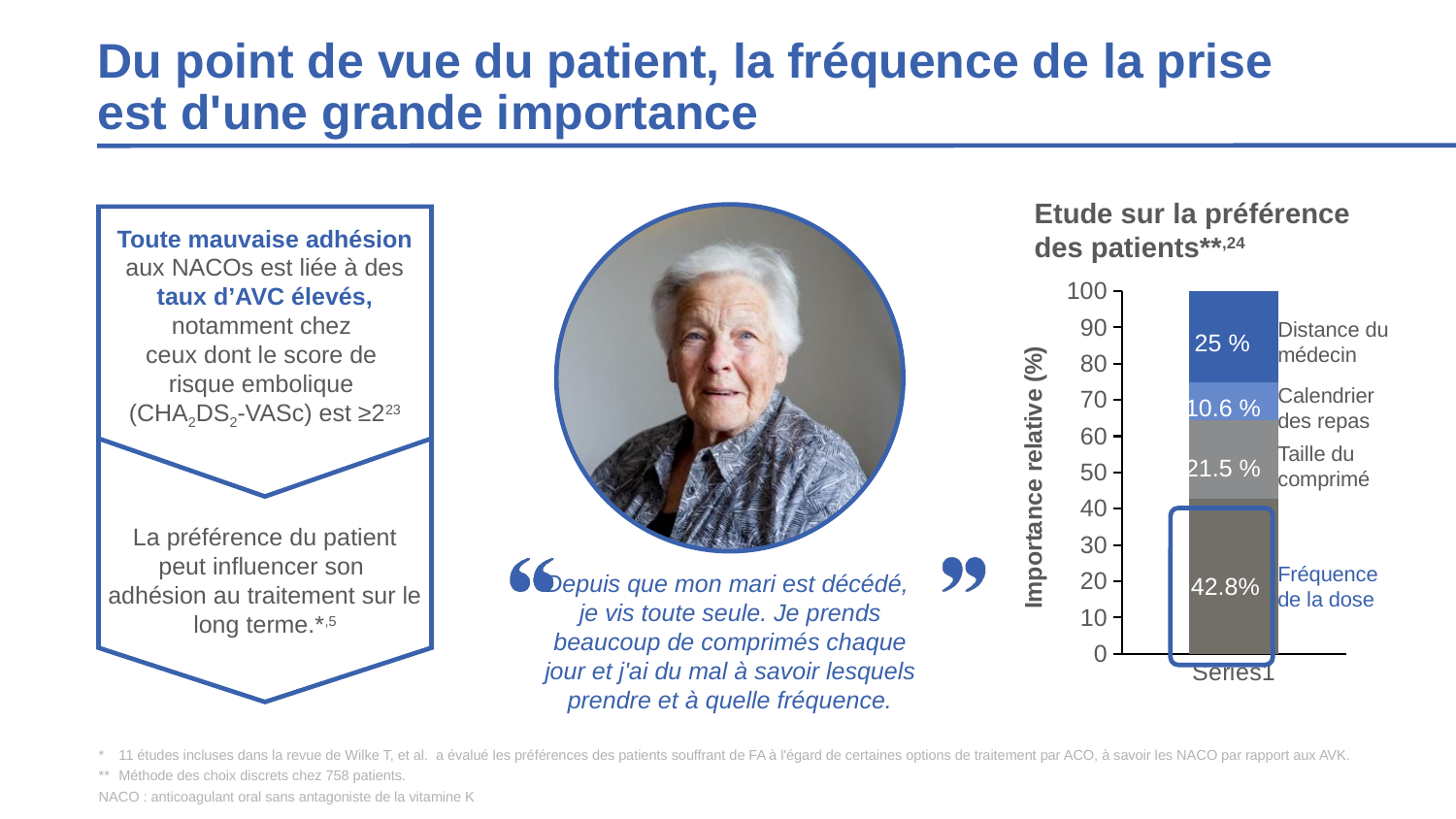
Which has a larger value, "Distance du médecin" or "Taille du comprimé"? Distance du médecin What type of chart is used to show the patient preference study? Stacked bar chart How many factors (segments) are shown in the stacked bar? 4 What is the label of the y axis of the chart? Importance relative (%) What is the difference between the values for "Taille du comprimé" and "Calendrier des repas"? 10.9 Which factor has the highest relative importance in the chart? Fréquence de la dose What is the relative importance value shown for "Fréquence de la dose" in the patient preference chart? 42.8% What value is shown for "Calendrier des repas" in the chart? 10.6 % Which factor has the lowest relative importance in the chart? Calendrier des repas What value is shown for "Taille du comprimé" in the chart? 21.5 % What value is shown for "Distance du médecin" in the stacked bar? 25 % What is the difference between the values for "Fréquence de la dose" and "Distance du médecin"? 17.8